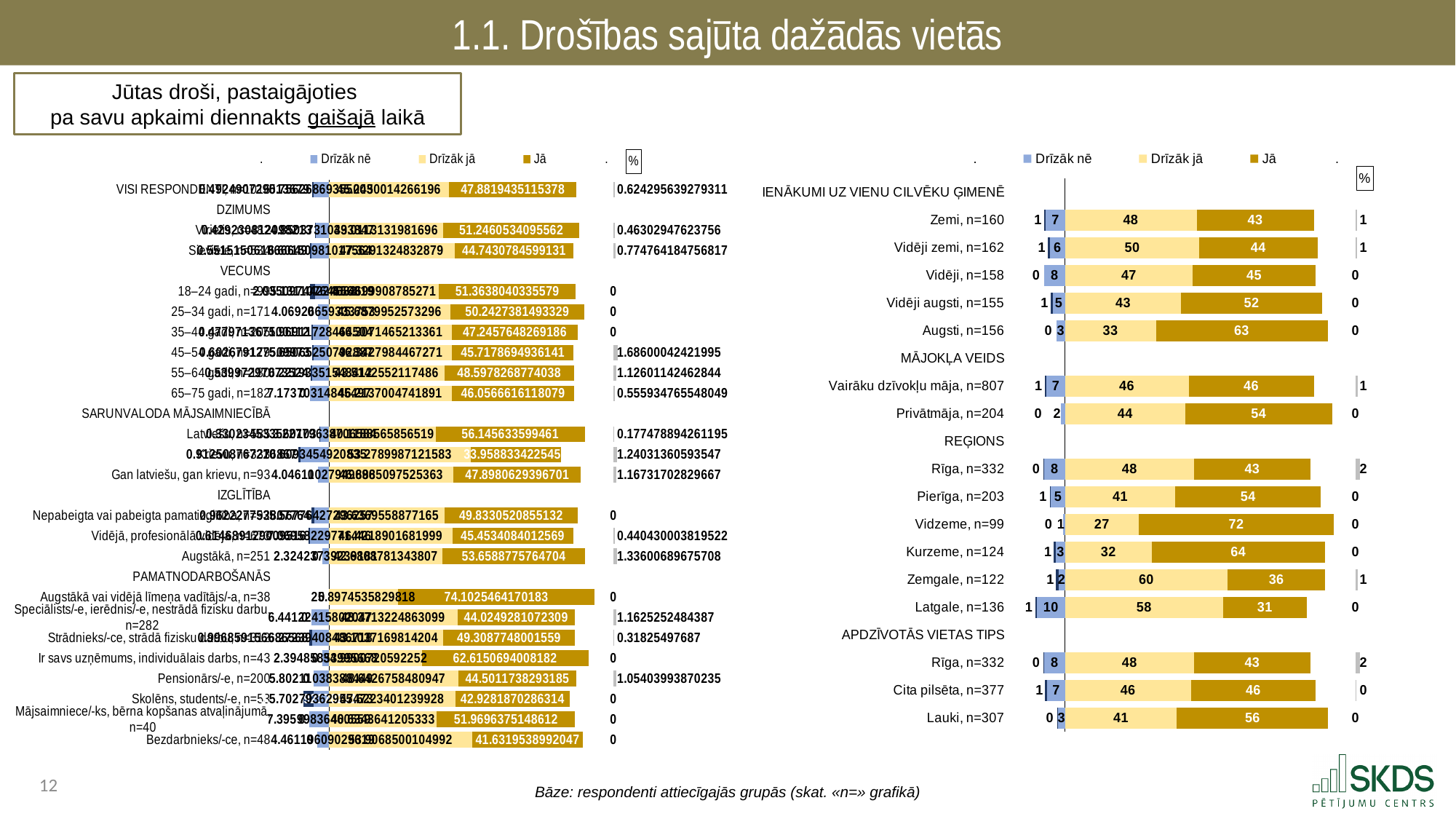
On the chart on the right, what is the "Drīzāk jā" value for Zemgale, n=122? 60 On the chart on the right, what is the difference between the "Jā" values for Augsti, n=156 and Zemi, n=160? 20 On the chart on the right, what is the "Drīzāk jā" value for Augsti, n=156? 33 On the chart on the right, which region under REĢIONS has the lowest "Jā" value? Latgale, n=136 On the chart on the right, which region under REĢIONS has the highest "Jā" value? Vidzeme, n=99 On the chart on the left, what is the "Jā" value for VISI RESPONDENTI? 47.8819435115378 On the chart on the right, what is the "Jā" value for Lauki, n=307? 56 On the chart on the right, what is the "Jā" value for Vidzeme, n=99? 72 What kind of chart is the chart on the right? Stacked bar chart On the chart on the right, which has the larger "Jā" value: Privātmāja, n=204 or Vairāku dzīvokļu māja, n=807? Privātmāja, n=204 On the chart on the right, what is the "Drīzāk nē" value for Latgale, n=136? 10 How many series does the legend of the chart on the right list? 3